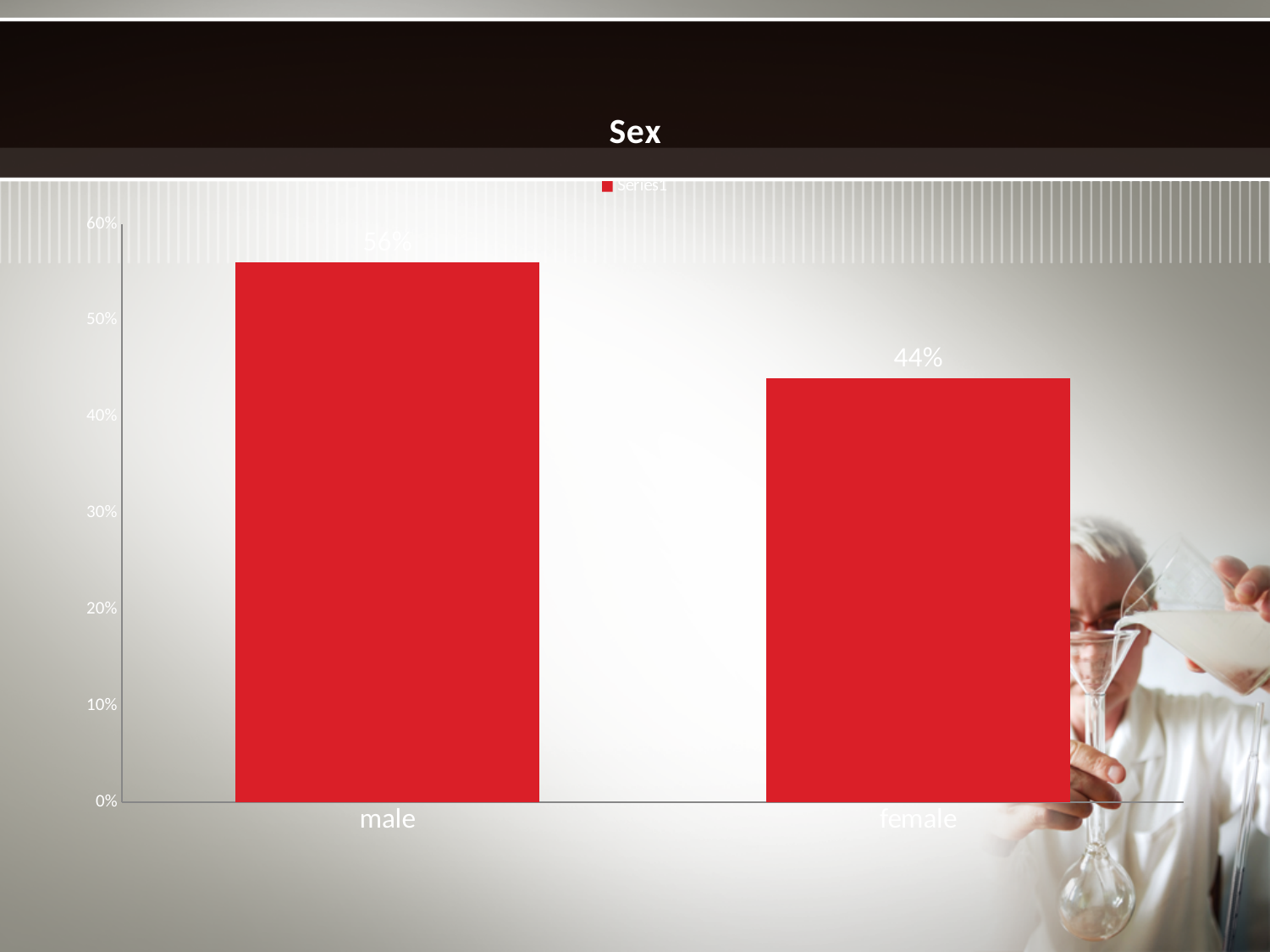
What is the value for male? 56% What is the value for female? 44% Is the value for male greater or less than 50%? greater Which category has the lowest value? female What kind of chart is shown? bar chart How many categories are shown on the x axis? 2 How many series does the legend list? 1 Which category has the highest value? male What is the title of the chart? Sex Is the value for female greater or less than 50%? less What is the difference between the values for male and female? 12% Which is larger, the value for male or the value for female? male